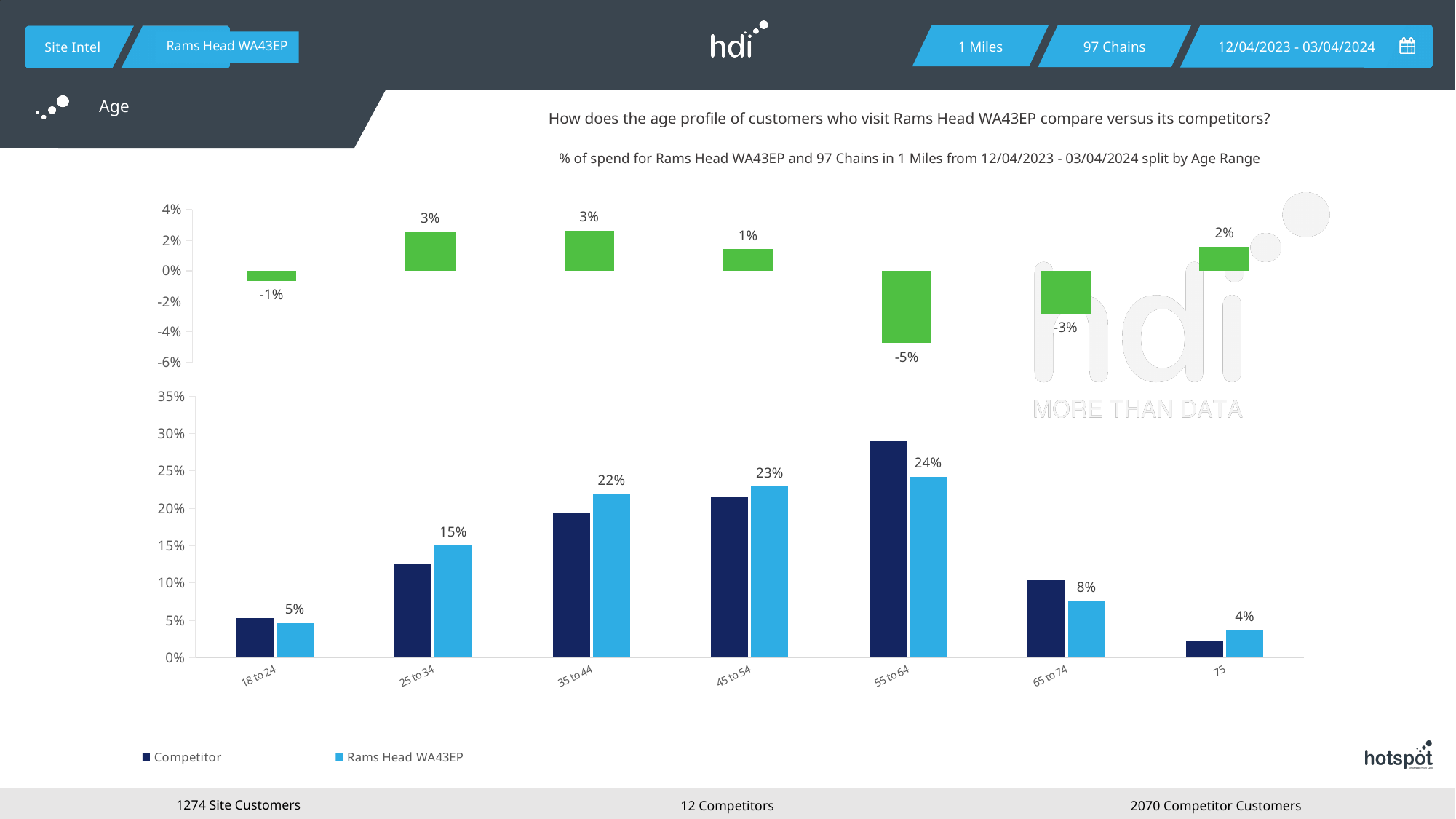
In the bottom chart, what is the difference between the Rams Head WA43EP values for 55 to 64 and 18 to 24? 19% In the top chart, what is the value shown for the 55 to 64 age range? -5% How many series does the legend of the bottom chart list? 2 What kind of chart is the bottom chart? bar chart In the bottom chart, is the Competitor value for 55 to 64 greater or less than 25%? greater In the bottom chart, what is the value for Rams Head WA43EP in the 25 to 34 age range? 15% In the bottom chart, which age range has the lowest value for Rams Head WA43EP? 75 In the bottom chart, what is the value for Rams Head WA43EP in the 55 to 64 age range? 24% In the bottom chart, is the Competitor value for 25 to 34 greater or less than 15%? less In the bottom chart, for the 55 to 64 age range, which series has the larger value: Competitor or Rams Head WA43EP? Competitor In the bottom chart, which age range has the highest value for Rams Head WA43EP? 55 to 64 How many age range categories are shown on the x axis of the bottom chart? 7